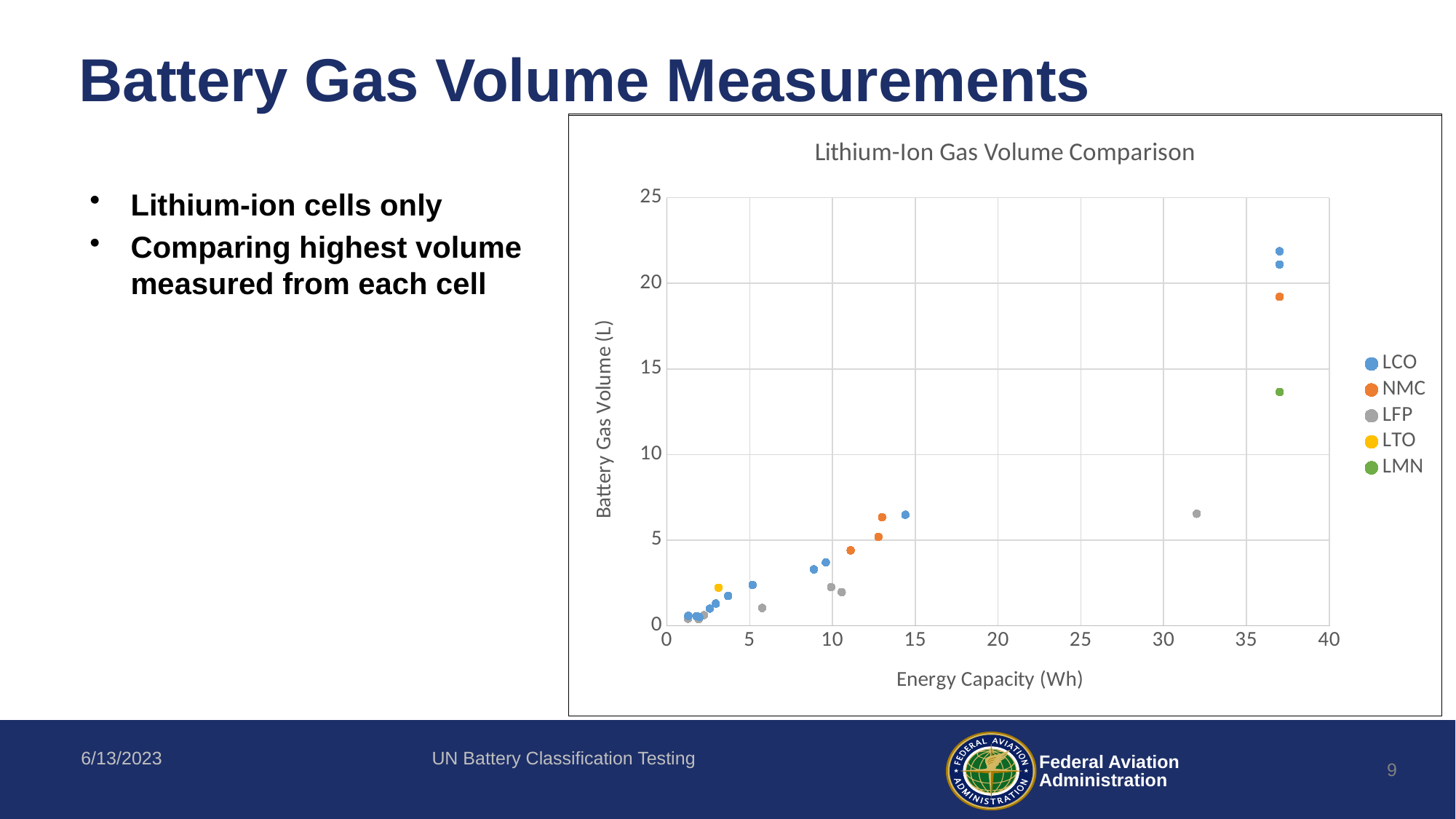
How many LTO points are plotted on the chart? 1 Is the highest NMC point's battery gas volume greater or less than 15? greater Which series has the highest battery gas volume point on the chart? LCO Is the battery gas volume of the LFP point near 32 Wh greater or less than 10? less What is the title of the chart? Lithium-Ion Gas Volume Comparison What kind of chart is shown on the slide? scatter chart Does battery gas volume generally rise or fall as energy capacity increases along the x axis? rise Is the highest LCO point's battery gas volume greater or less than 20? greater Which series are listed in the chart's legend? LCO, NMC, LFP, LTO, LMN How many series does the legend of the chart list? 5